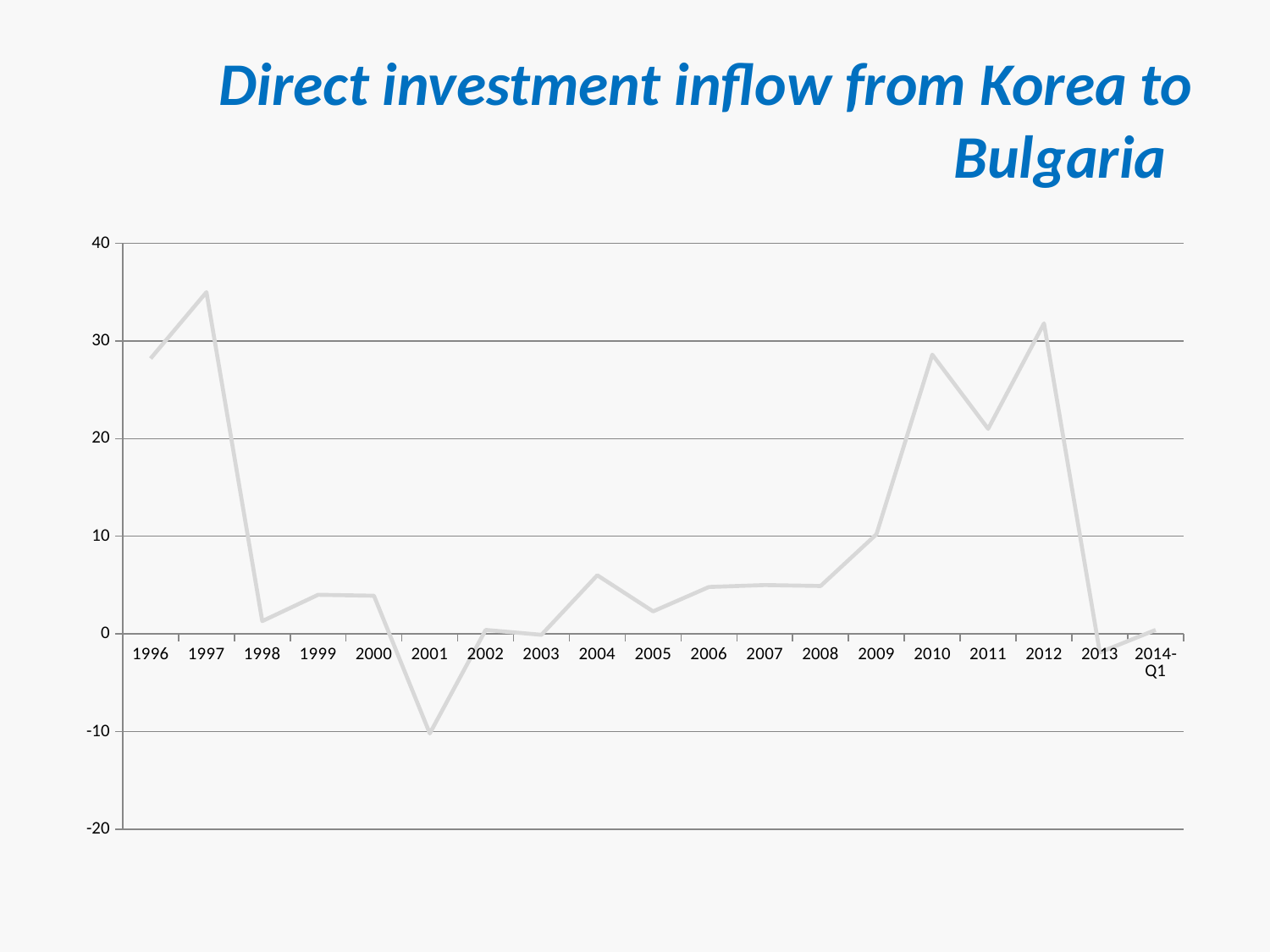
Which is larger, the value for 2010 or the value for 2011? 2010 Is the value for 1998 greater or less than 10? less Which year has the highest value? 1997 Is the value for 2001 greater or less than 0? less Does the value rise or fall from 2012 to 2013? fall What is the title of the chart? Direct investment inflow from Korea to Bulgaria Is the value for 2010 greater or less than 20? greater Which year has the lowest value? 2001 Which is larger, the value for 1996 or the value for 1999? 1996 How many time periods are plotted along the x axis? 19 What kind of chart is shown on the slide? line chart